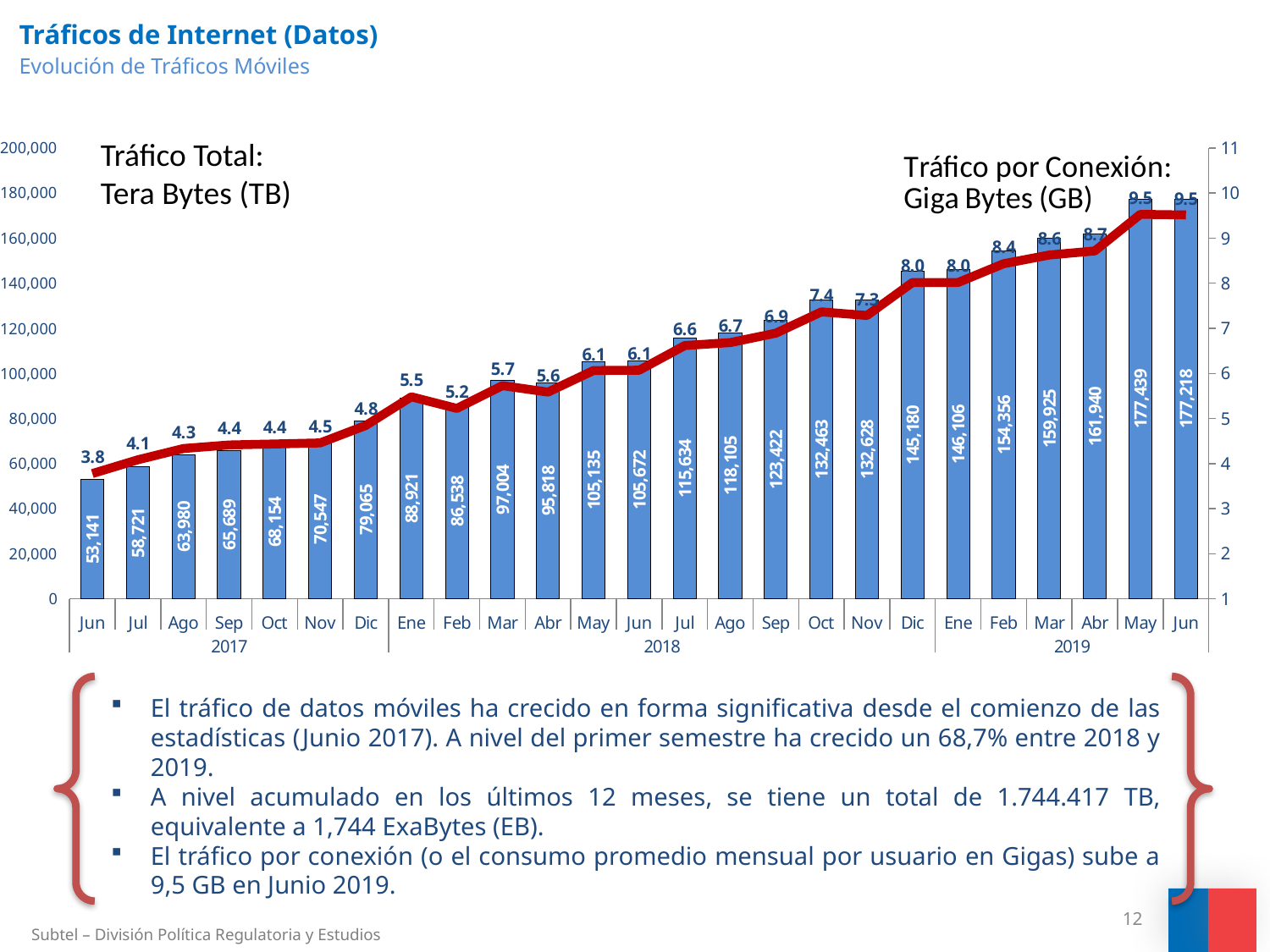
What is the total mobile traffic (TB) for Jun 2019? 177,218 Is the total traffic (TB) bar for Dic 2018 greater or less than 140,000? greater What kind of chart is shown on the slide? Combined bar and line chart What is the traffic per connection (GB) for Dic 2018? 8.0 How many months are plotted on the x axis? 25 Which month has the highest total traffic (TB) bar? May 2019 Does the traffic per connection (GB) line generally rise or fall from Jun 2017 to Jun 2019? Rise Which month has the lowest total traffic (TB) bar? Jun 2017 What unit is used for the bars labelled 'Tráfico Total'? Tera Bytes (TB) Which month has the larger total traffic (TB): Ene 2018 or Feb 2018? Ene 2018 What is the difference in total traffic (TB) between Jun 2019 and Jun 2018? 71,546 What is the total traffic (TB) for Mar 2018? 97,004